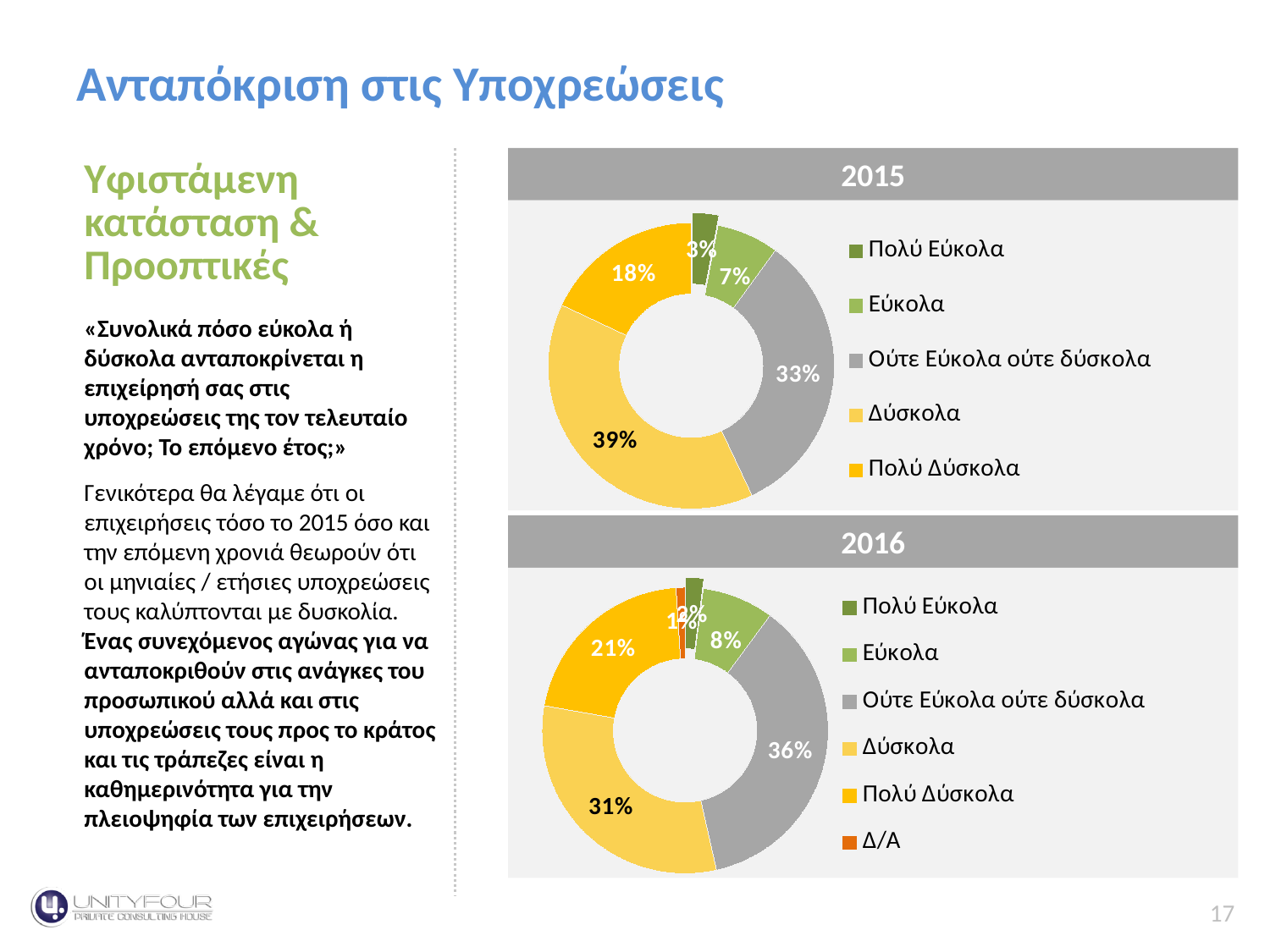
In the 2015 chart, what percentage is shown for Ούτε Εύκολα ούτε δύσκολα? 33% In the 2016 chart, which is larger, Δύσκολα or Πολύ Δύσκολα? Δύσκολα What type of chart is used for the 2015 data? Doughnut chart In the 2015 chart, which category has the smallest share? Πολύ Εύκολα In the 2015 chart, what percentage is shown for Δύσκολα? 39% In the 2015 chart, which category has the largest share? Δύσκολα How many categories does the legend of the 2016 chart list? 6 In the 2016 chart, what percentage is shown for Πολύ Δύσκολα? 21% In the 2015 chart, what is the difference between the Δύσκολα and Πολύ Δύσκολα shares? 21% In the 2016 chart, which category has the largest share? Ούτε Εύκολα ούτε δύσκολα In the 2015 chart, what percentage is shown for Πολύ Δύσκολα? 18% In the 2016 chart, what percentage is shown for Ούτε Εύκολα ούτε δύσκολα? 36%